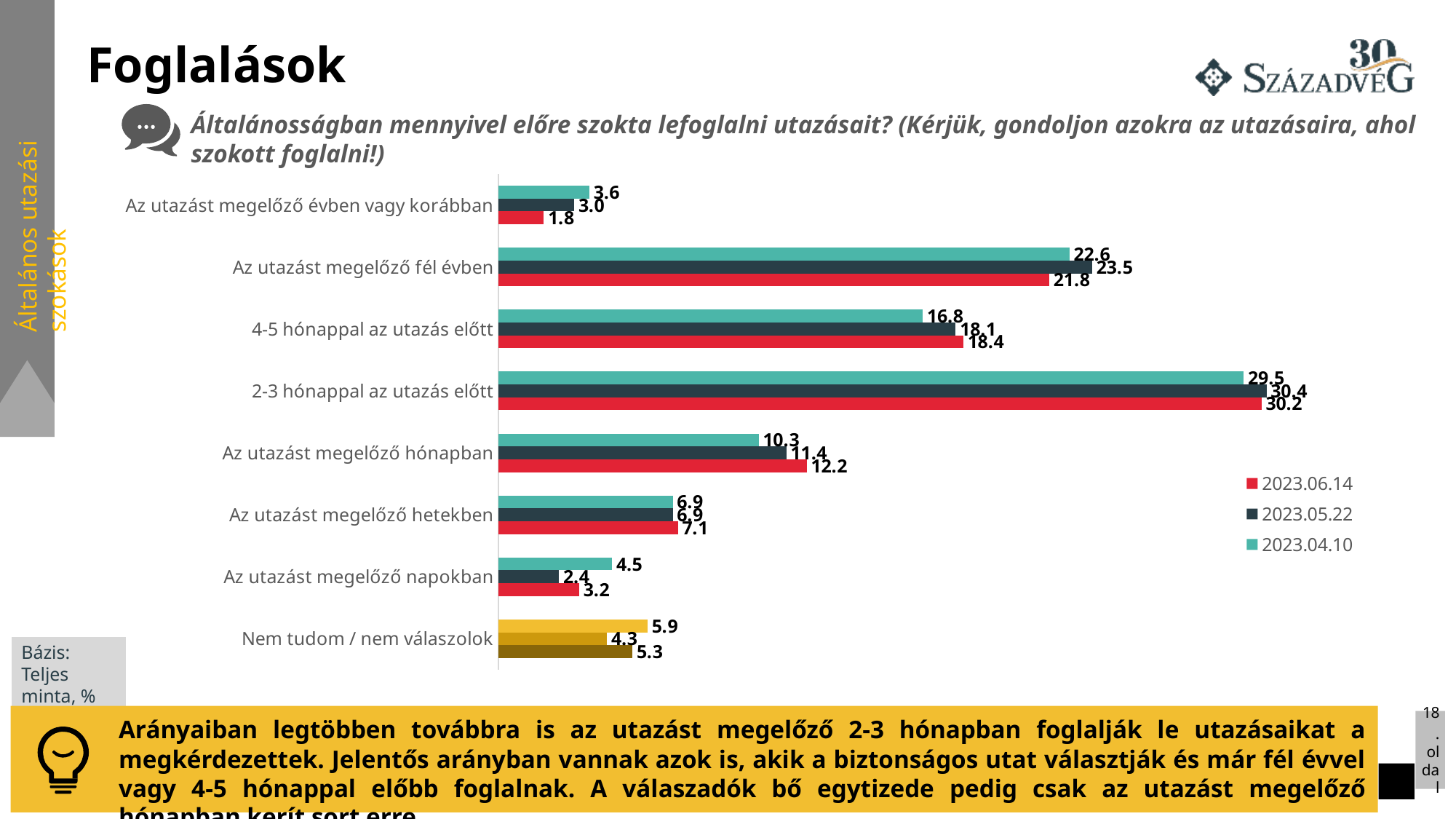
For "4-5 hónappal az utazás előtt", which series has the larger value: 2023.06.14 or 2023.04.10? 2023.06.14 What is the difference between the 2023.06.14 and 2023.04.10 values for "Az utazást megelőző hónapban"? 1.9 How many categories are shown on the chart? 8 Which series is shown in red in the legend? 2023.06.14 What kind of chart is shown on the slide? bar chart What is the value for "2-3 hónappal az utazás előtt" in the 2023.06.14 series? 30.2 What is the value for "Az utazást megelőző fél évben" in the 2023.05.22 series? 23.5 Which category has the highest value in the 2023.06.14 series? 2-3 hónappal az utazás előtt What is the value for "Az utazást megelőző napokban" in the 2023.04.10 series? 4.5 How many series does the legend list? 3 What is the value for "Nem tudom / nem válaszolok" in the middle (2023.05.22) bar? 4.3 Which category has the lowest value in the 2023.06.14 series? Az utazást megelőző évben vagy korábban